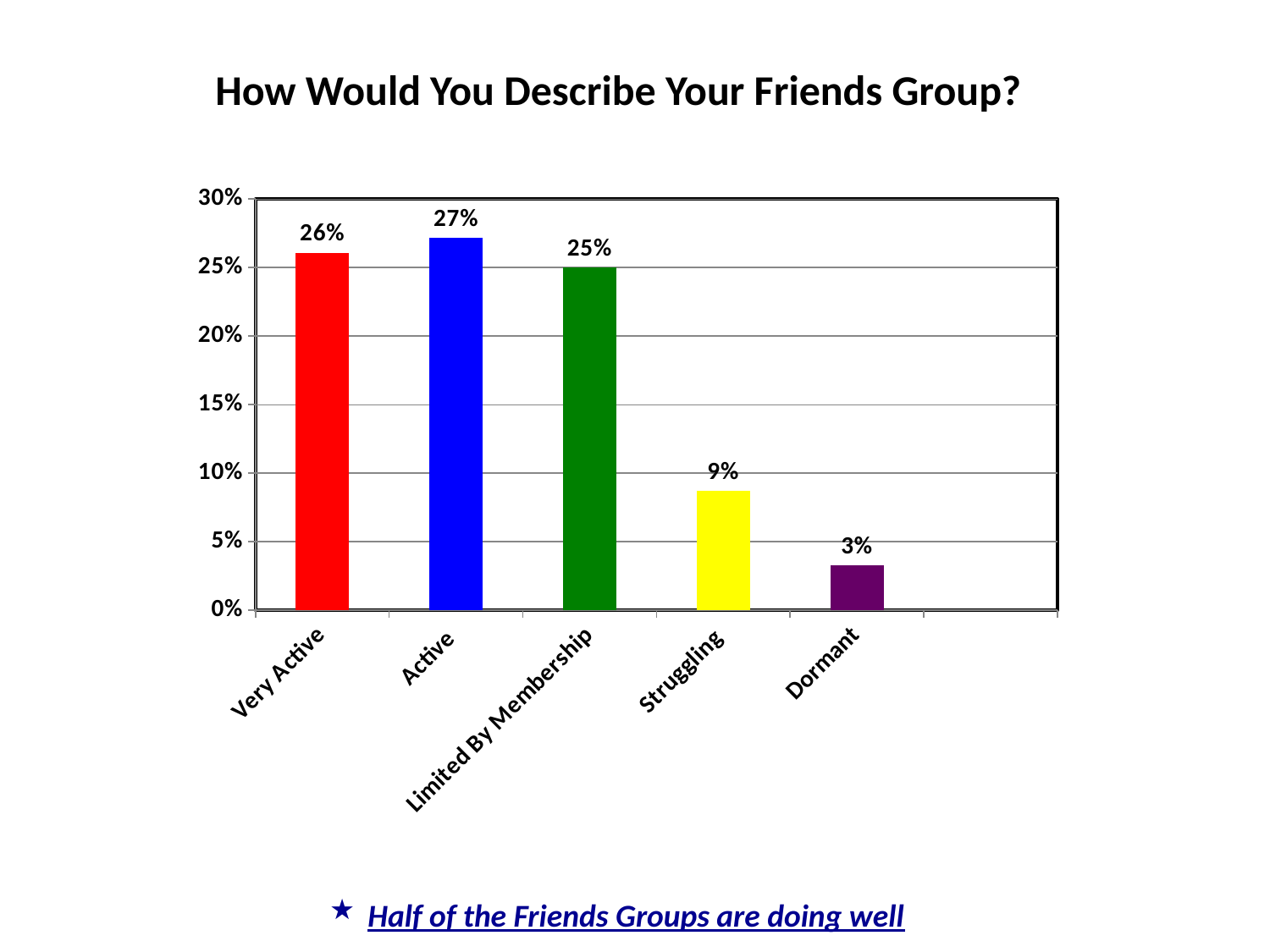
Is the value for Limited By Membership greater or less than 20%? greater What is the difference between the Limited By Membership and Struggling values? 16% Which category has the lowest value? Dormant Which category has the highest value? Active How many categories are shown on the x axis? 5 What percentage is shown for Dormant? 3% What colour is the bar for Limited By Membership? Green What percentage of respondents described their Friends Group as Very Active? 26% What is the value shown for the Struggling category? 9% Which is larger, the value for Struggling or the value for Dormant? Struggling What is the difference between the Active and Dormant values? 24% What kind of chart is shown on the slide? Bar chart